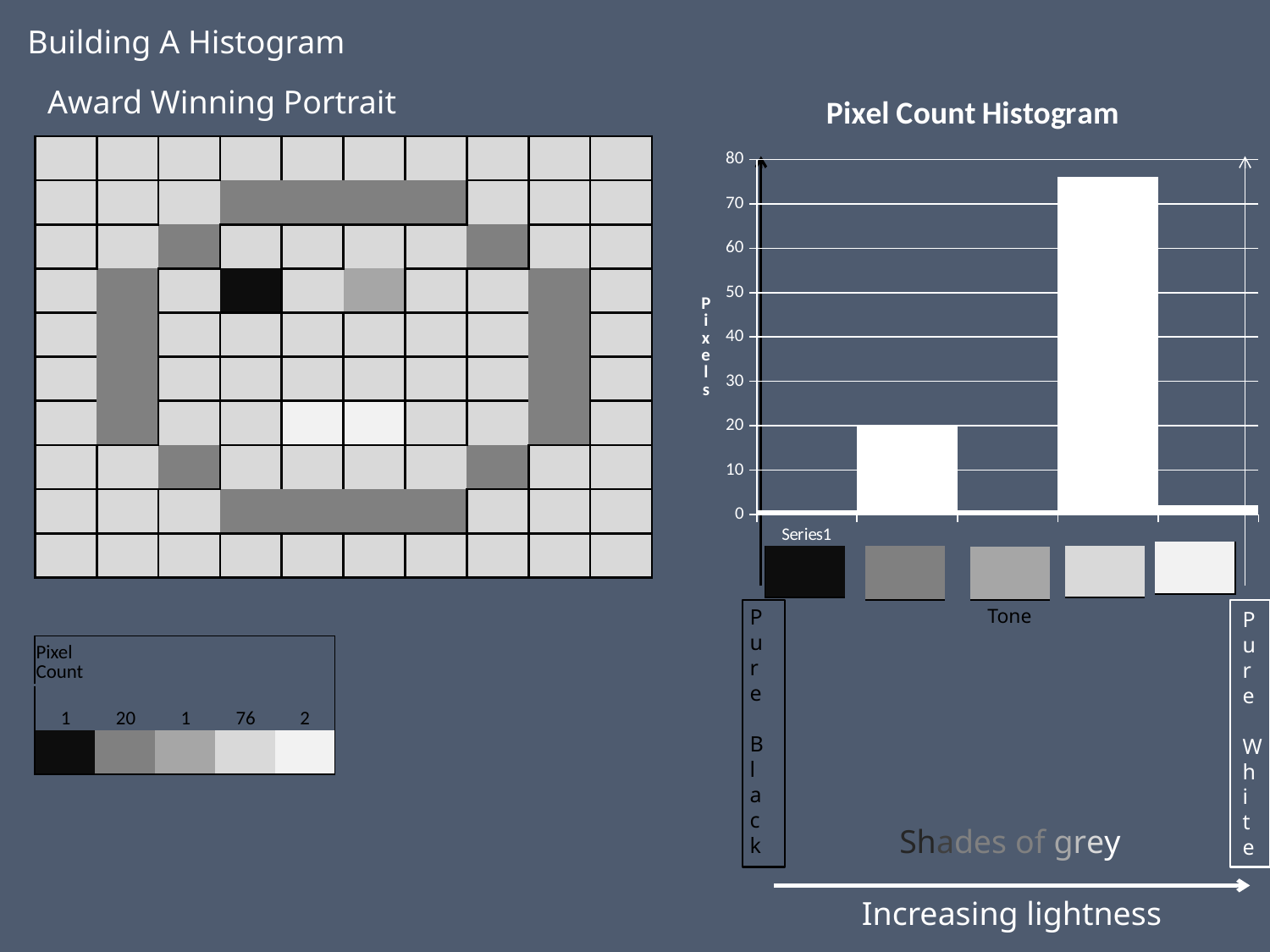
In the Pixel Count Histogram, is the value of the fifth bar (white tone) greater or less than 10? less In the Pixel Count Histogram, what is the value of the second bar (dark grey tone)? 20 What is the name of the series shown in the legend of the Pixel Count Histogram? Series1 In the Pixel Count Histogram, is the value of the fourth bar (light grey tone) greater or less than 70? greater In the Pixel Count Histogram, is the value of the first bar (black tone) greater or less than 10? less What kind of chart is the Pixel Count Histogram? bar chart How many series does the legend of the Pixel Count Histogram list? 1 In the Pixel Count Histogram, which bar is the highest? the fourth bar (light grey tone) What is the title of the chart on the slide? Pixel Count Histogram How many bars are plotted in the Pixel Count Histogram? 5 In the Pixel Count Histogram, which is larger: the second bar (dark grey tone) or the fourth bar (light grey tone)? the fourth bar (light grey tone)